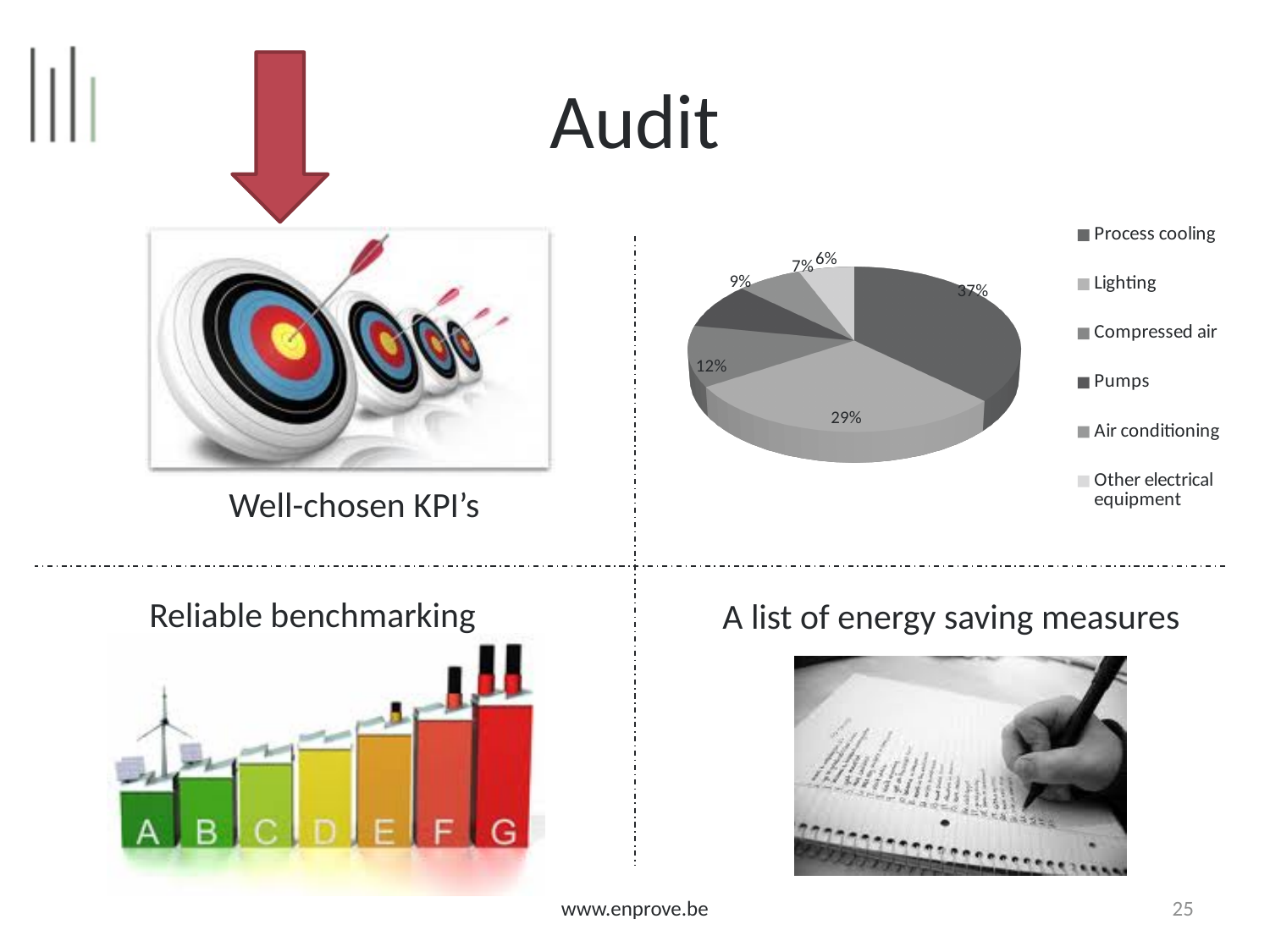
What is the difference in percentage points between Process cooling and Lighting? 8 Which category has the largest slice of the pie? Process cooling What kind of chart is shown on the slide? pie chart What share of the pie does Lighting take? 29% How many categories does the pie chart have? 6 Which is larger, the share for Pumps or the share for Air conditioning? Pumps What share of the pie does Compressed air take? 12% Which category has the smallest slice of the pie? Other electrical equipment What share of the pie does Process cooling take? 37% Which legend entry is listed first in the pie chart's legend? Process cooling What share of the pie does Other electrical equipment take? 6% What share of the pie does Pumps take? 9%